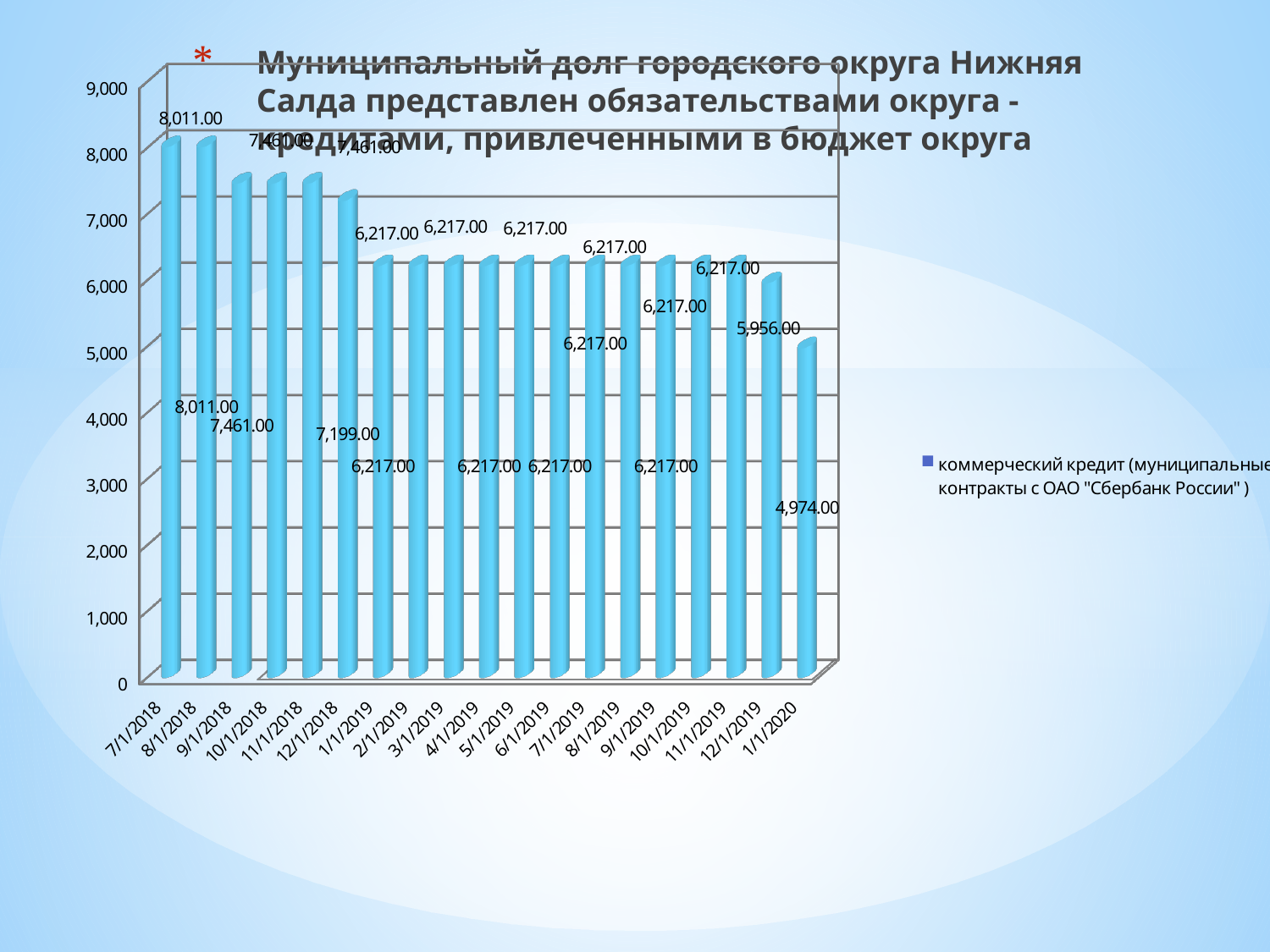
Which date has the lowest value? 1/1/2020 What is the value for 12/1/2018? 7,199.00 What is the value for 12/1/2019? 5,956.00 What is the difference between the values for 11/1/2018 and 12/1/2018? 262.00 Do the values generally rise or fall from 7/1/2018 to 1/1/2020? fall Is the value for 5/1/2019 greater or less than 7,000? less How many series does the legend list? 1 What is the difference between the values for 7/1/2018 and 1/1/2020? 3,037.00 How many dates are shown on the x axis? 19 What is the value for 1/1/2020? 4,974.00 What is the value for 7/1/2018? 8,011.00 Which is larger, the value for 12/1/2019 or the value for 1/1/2020? 12/1/2019